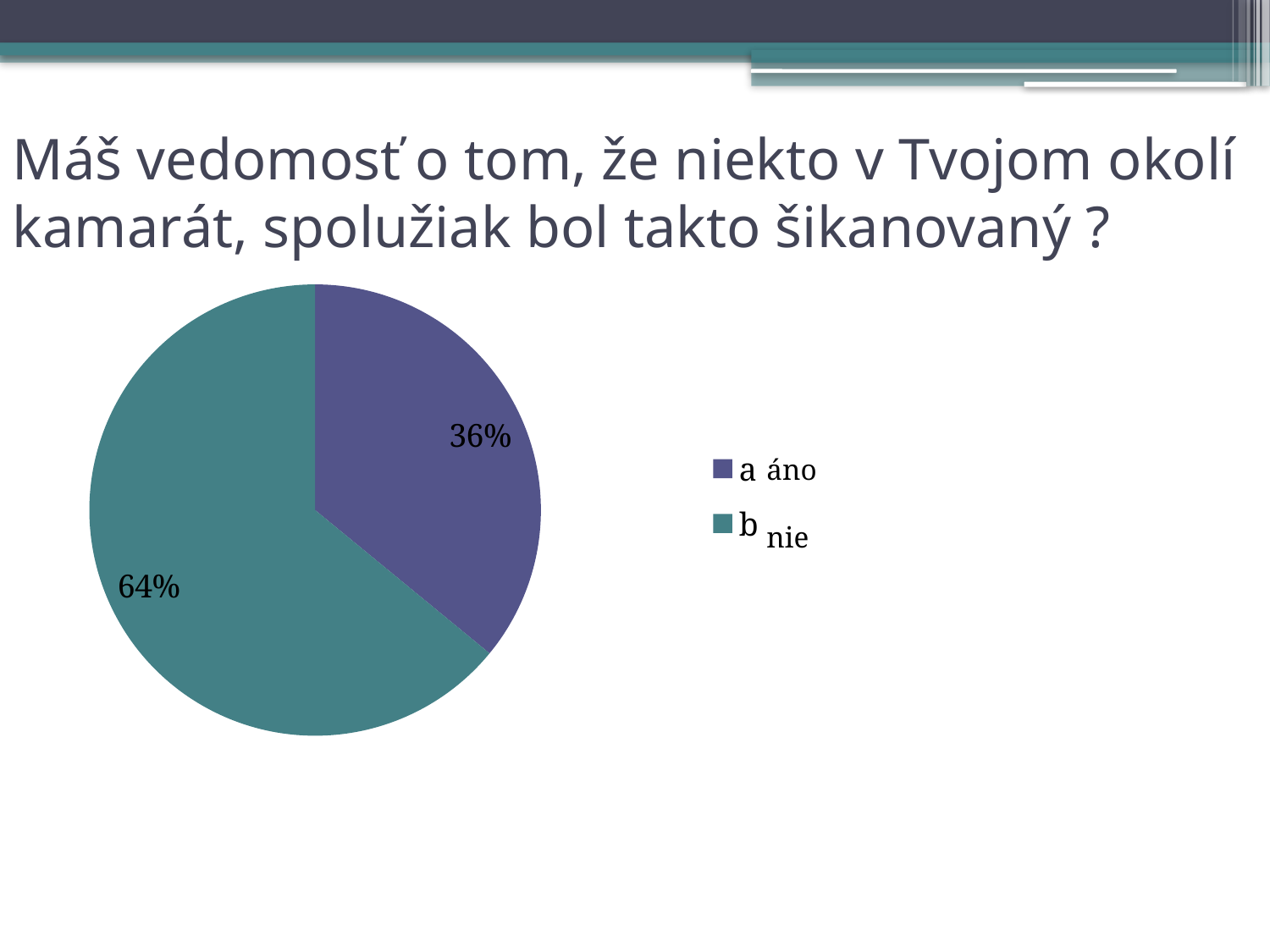
What share of the pie does the 'b nie' slice represent? 64% How many slices does the pie chart have? 2 Which is larger, the 'a áno' slice or the 'b nie' slice? b nie Which slice is the largest? b nie What is the title of the slide above the chart? Máš vedomosť o tom, že niekto v Tvojom okolí kamarát, spolužiak bol takto šikanovaný ? What share of the pie does the 'a áno' slice represent? 36% Is the value for 'a áno' greater or less than 50%? less What is the difference in percentage points between the 'b nie' and 'a áno' slices? 28% What kind of chart is shown on the slide? pie chart What colour is the 'b nie' slice? teal Which slice is the smallest? a áno How many entries does the legend list? 2